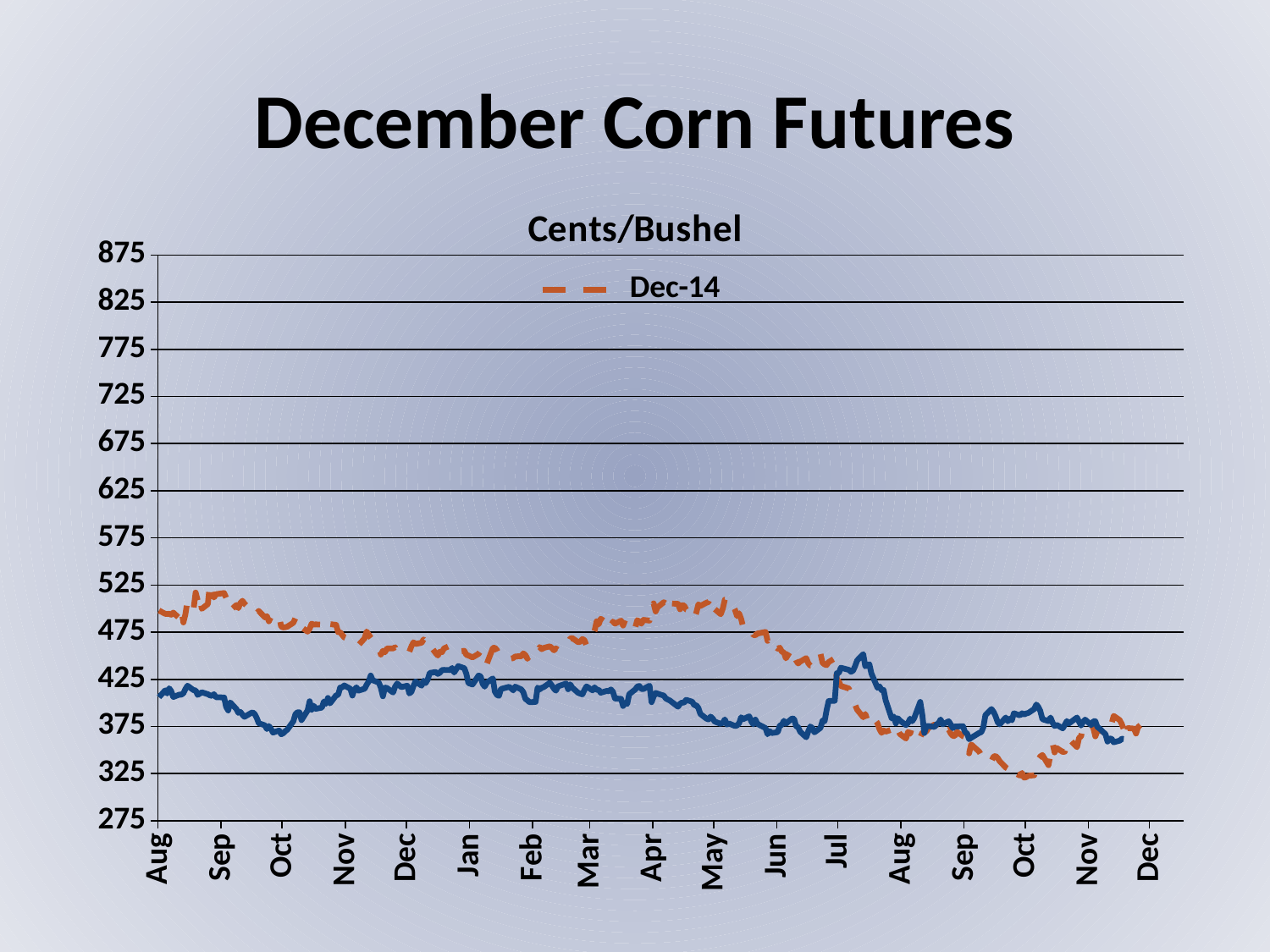
Overall, does the Dec-14 line rise or fall from the first Aug label to the final Dec label? fall At Apr, which line is higher: the dashed Dec-14 line or the solid blue line? Dec-14 Is the solid blue line's value at Jan greater or less than 400? greater Is the Dec-14 value at the first Aug label greater or less than 450? greater What is the name of the series listed in the legend? Dec-14 Is the solid blue line's value at Jun greater or less than 400? less How many series does the chart's legend list? 1 What is the title printed above the chart's plot area? Cents/Bushel What kind of chart is shown on the slide? line chart